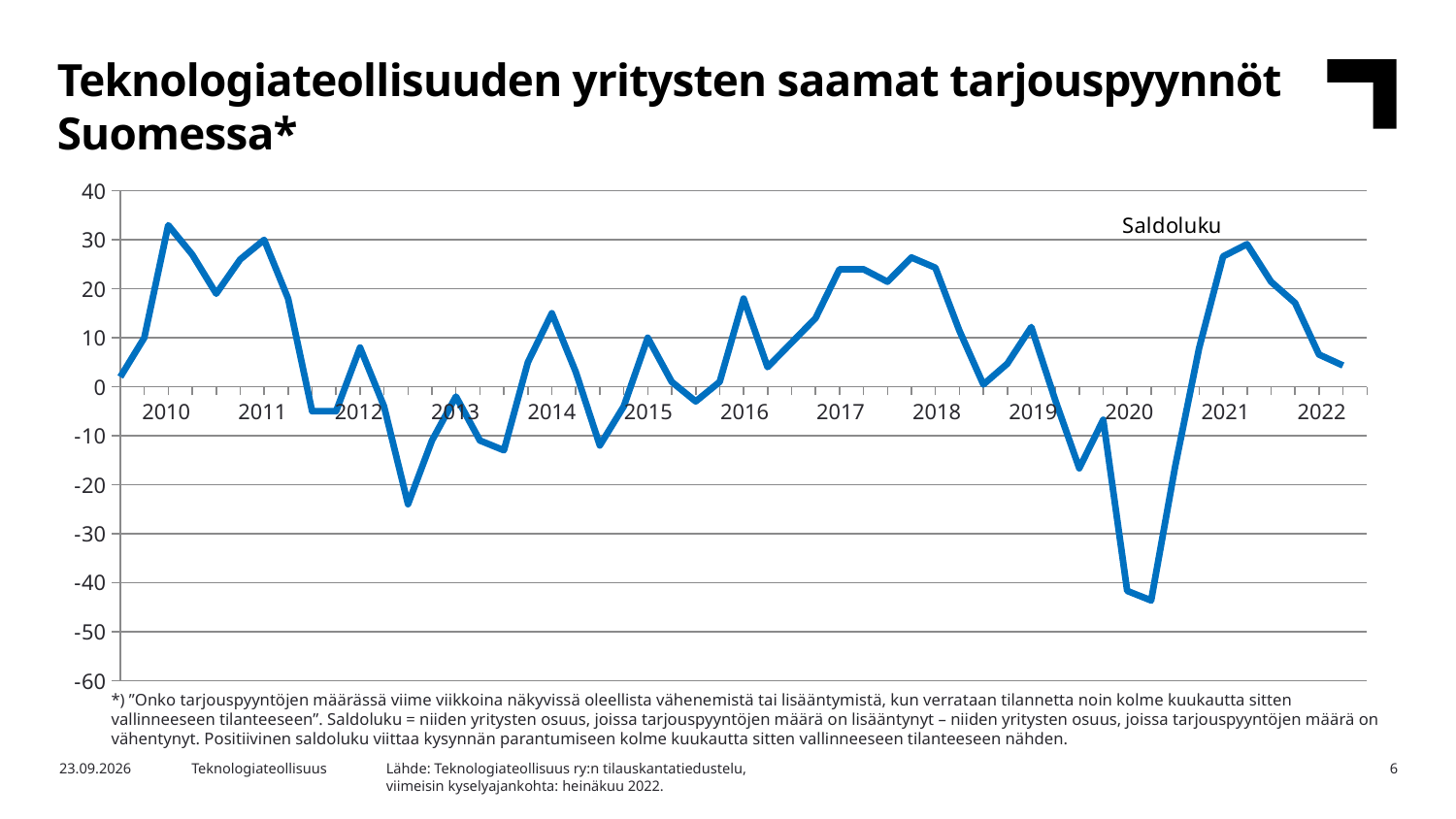
Is the lowest value of the line in 2020 greater or less than -30? less Which is larger: the lowest value of the line in 2012 or the lowest value in 2020? 2012 How many years are labelled on the x axis of the chart? 13 Is the peak value of the line in 2021 greater or less than 20? greater In which year does the line reach its lowest value? 2020 What kind of chart is shown on the slide? line chart Does the line rise or fall from its low point in 2020 to its peak in 2021? rise Is the lowest value of the line in 2012 greater or less than -10? less How many data series does the chart plot? 1 Does the line rise or fall between its 2021 peak and the end of 2022? fall What is the name of the series plotted on the chart? Saldoluku